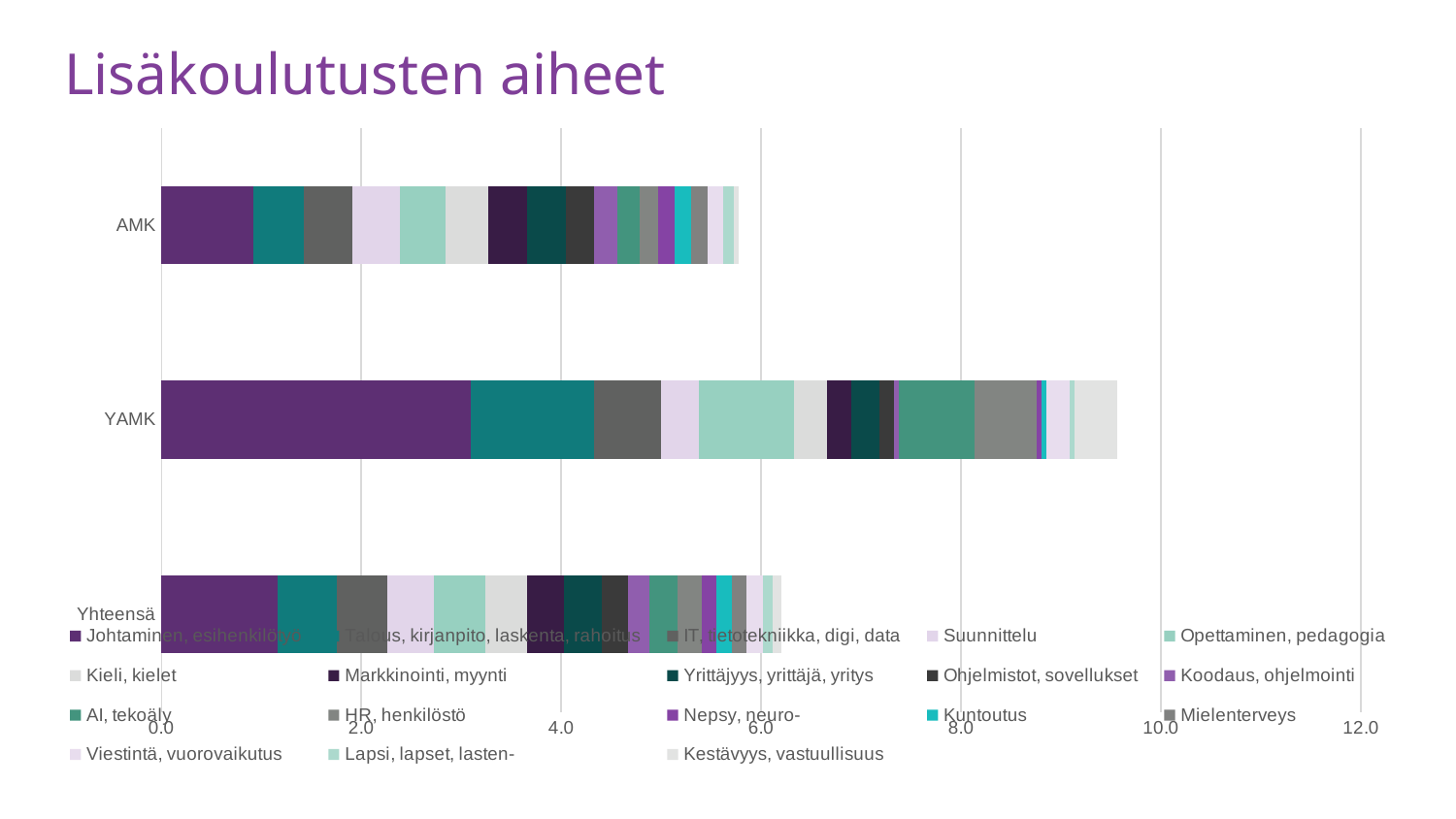
How many series does the legend list? 18 What is the title of the chart? Lisäkoulutusten aiheet Is the total bar length for Yhteensä greater or less than 4.0? greater Which total bar is longer, AMK or YAMK? YAMK Which category has the shortest total bar? AMK How many categories are shown on the vertical axis of the chart? 3 Which category has the longest total bar? YAMK Is the 'Johtaminen, esihenkilötyö' segment for YAMK greater or less than 2.0? greater Which legend entry is listed first? Johtaminen, esihenkilötyö Is the total bar length for YAMK greater or less than 8.0? greater What kind of chart is shown on the slide? Stacked bar chart